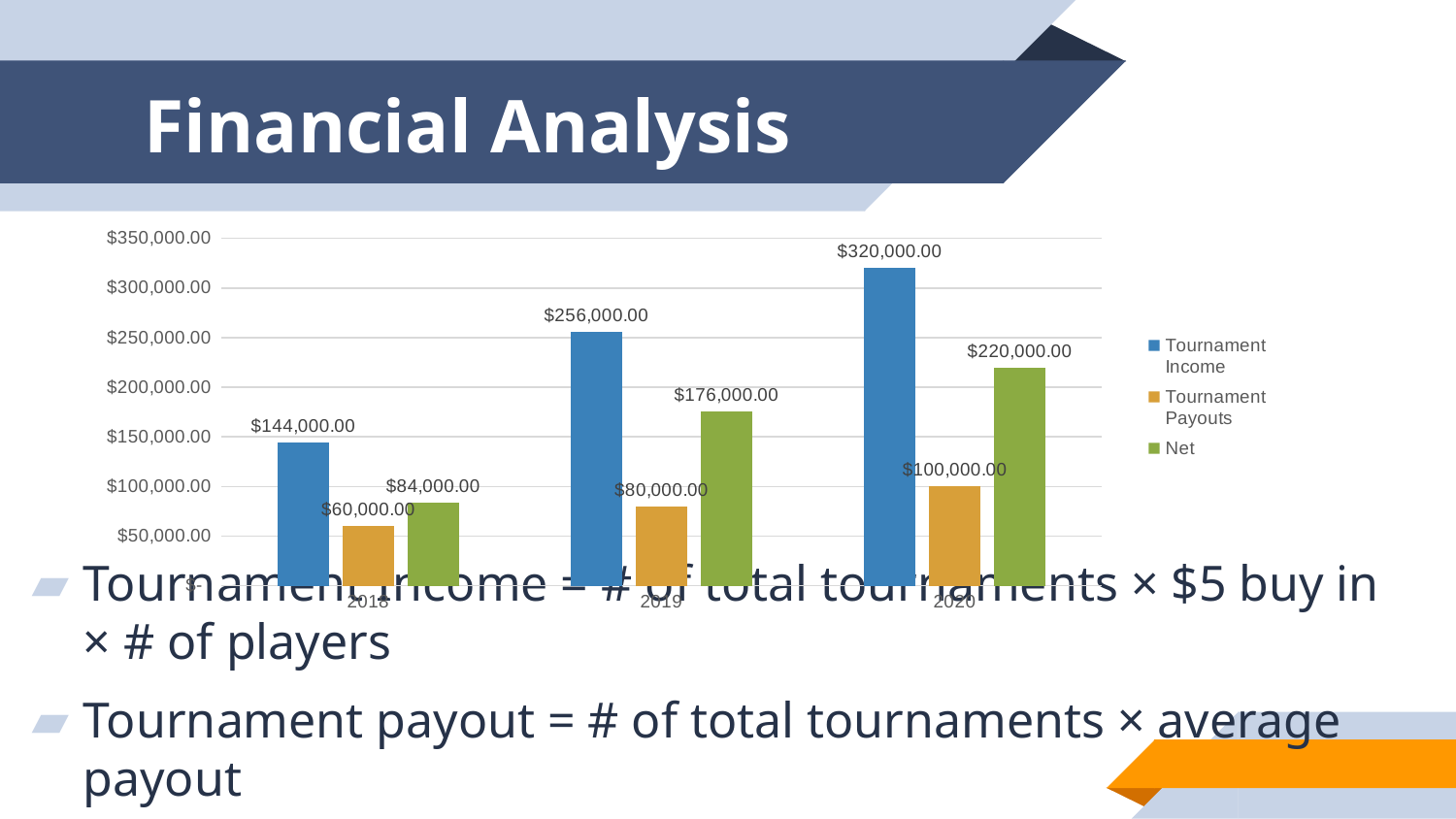
Is the Tournament Income value for 2018 greater or less than $100,000.00? greater What is the Net value for 2019? $176,000.00 What is the difference between Tournament Income and Tournament Payouts in 2019? $176,000.00 Which year has the highest Tournament Income? 2020 How many series does the legend list? 3 Which is larger in 2020: Tournament Payouts or Net? Net What is the Tournament Payouts value for 2018? $60,000.00 What is the Tournament Income value for 2020? $320,000.00 Which year has the lowest Net value? 2018 What kind of chart is shown on the slide? bar chart Does the Tournament Income rise or fall from 2018 to 2020? rise How many years are shown on the x axis? 3